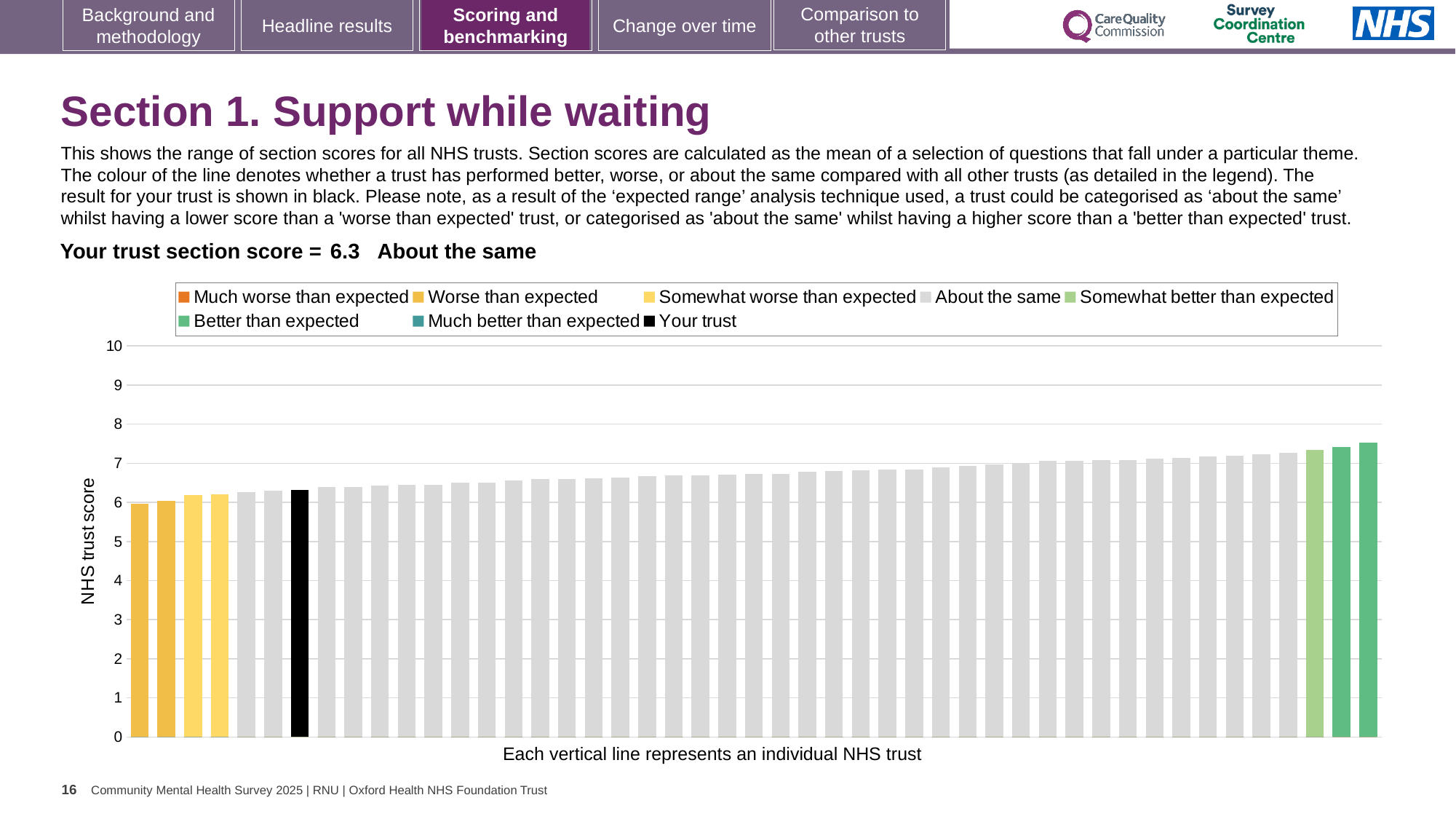
What kind of chart is shown on the slide? bar chart What is the label on the vertical axis of the chart? NHS trust score Is the highest bar in the chart greater or less than 8? less What is the section score for your trust shown on the slide? 6.3 What colour is the bar representing your trust? black Is the lowest bar in the chart greater or less than 5? greater Is the value for your trust greater or less than 5? greater Do the bar values rise or fall from left to right along the x axis? rise Which category is your trust placed in for this section? About the same How many bars are coloured as 'Better than expected'? 2 How many entries does the chart legend list? 8 How many bars are coloured as 'Somewhat better than expected'? 1